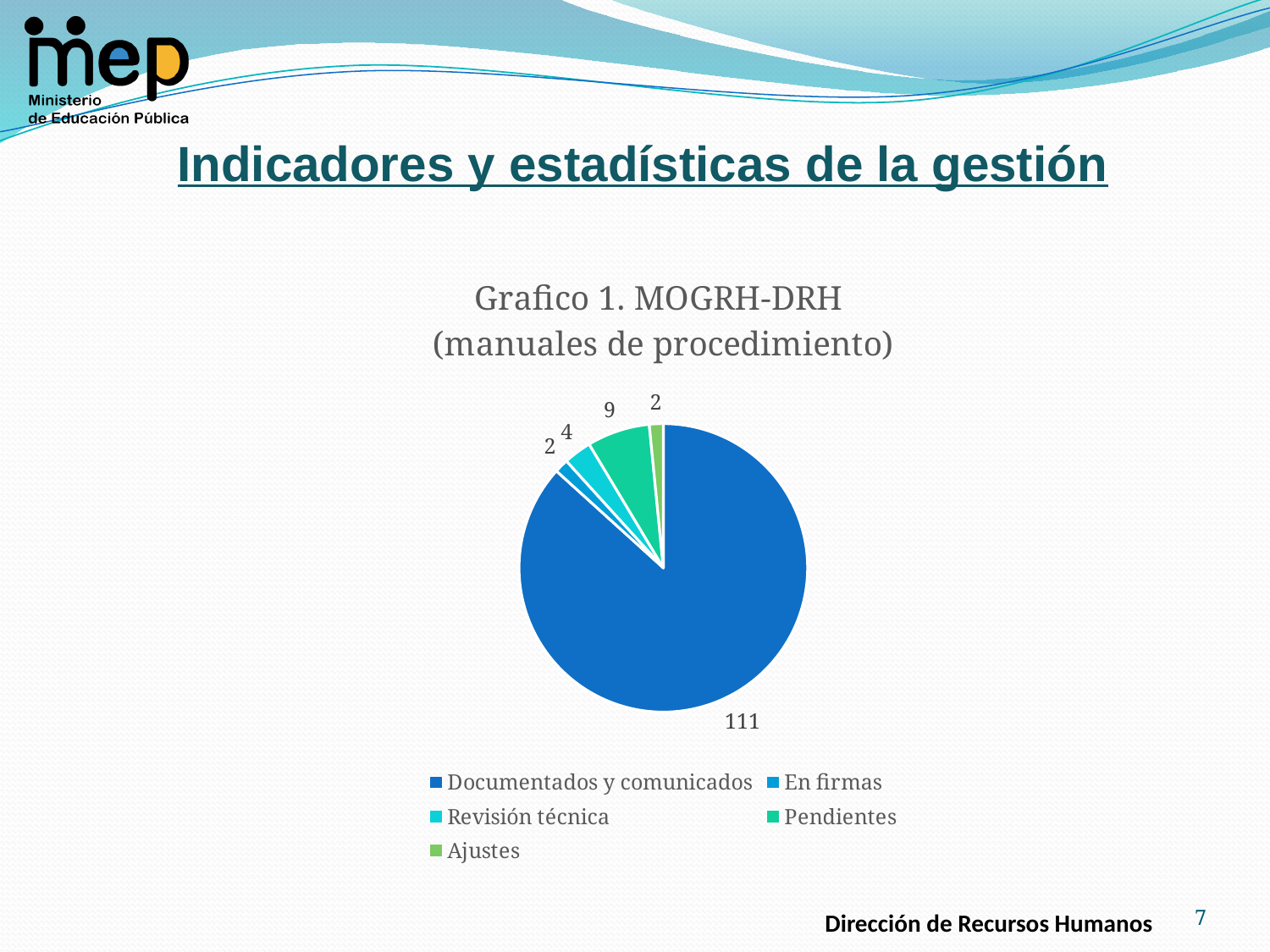
What is the difference between the values for Pendientes and Revisión técnica? 5 What is the difference between the values for Documentados y comunicados and Pendientes? 102 What is the value for Ajustes in the pie chart? 2 What is the total of all the slices in the pie chart? 128 What is the value for Revisión técnica in the pie chart? 4 Which category has the largest slice in the pie chart? Documentados y comunicados How many categories does the pie chart have? 5 Which is larger, the value for Pendientes or the value for Revisión técnica? Pendientes What is the value for Pendientes in the pie chart? 9 What is the title of the chart? Grafico 1. MOGRH-DRH (manuales de procedimiento) What type of chart is shown on the slide? Pie chart What is the value for Documentados y comunicados in the pie chart? 111